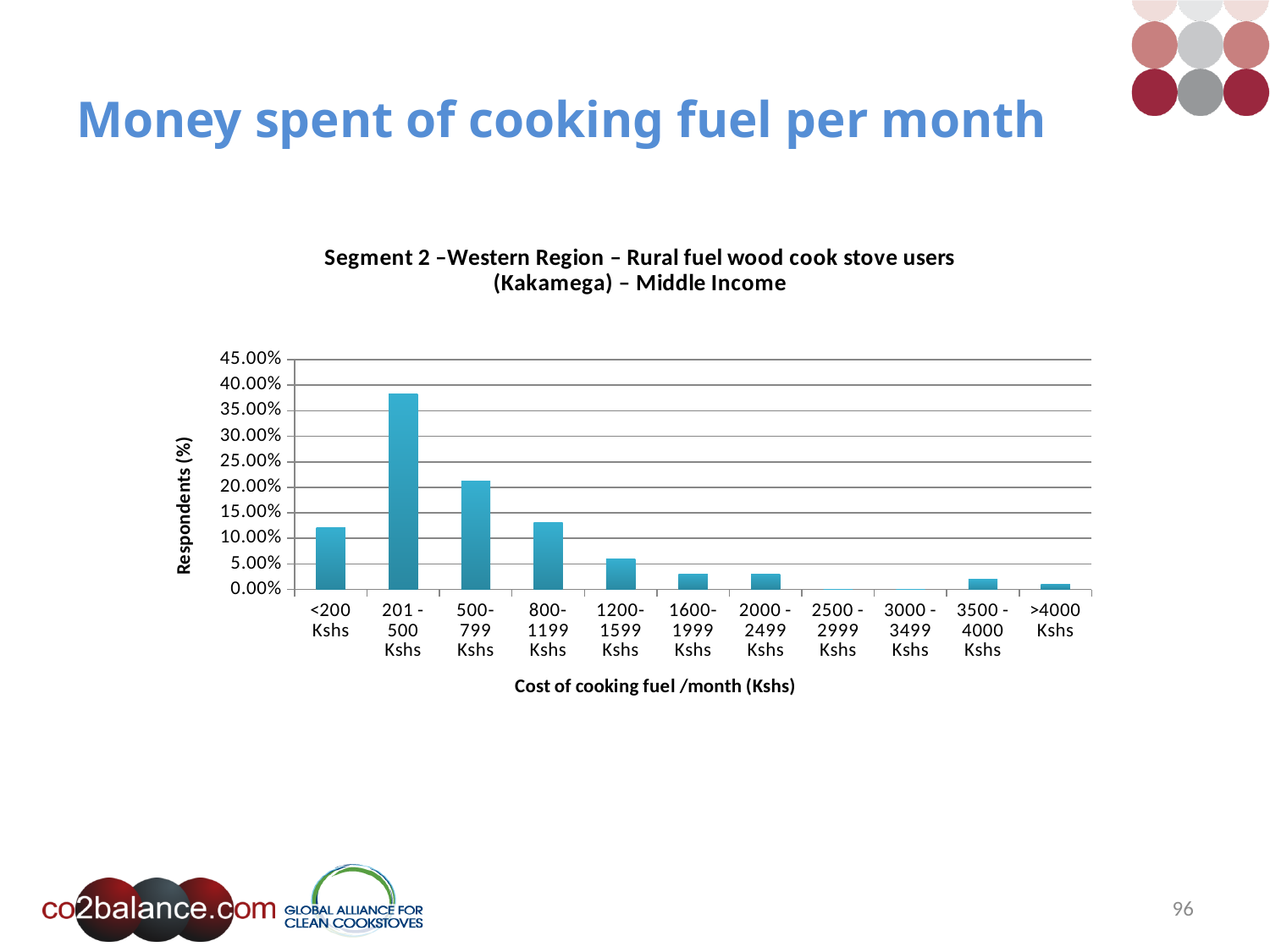
What is the label of the x axis? Cost of cooking fuel /month (Kshs) Which has a higher percentage of respondents, 500-799 Kshs or 800-1199 Kshs? 500-799 Kshs Is the value for 201 - 500 Kshs greater or less than 35.00%? greater Which has a higher percentage of respondents, <200 Kshs or 1200-1599 Kshs? <200 Kshs Is the value for 500-799 Kshs greater or less than 20.00%? greater Which cost category has the highest percentage of respondents? 201 - 500 Kshs How many cost categories are shown on the x axis? 11 Is the value for 1600-1999 Kshs greater or less than 5.00%? less What is the label of the y axis? Respondents (%) What kind of chart is shown on the slide? bar chart